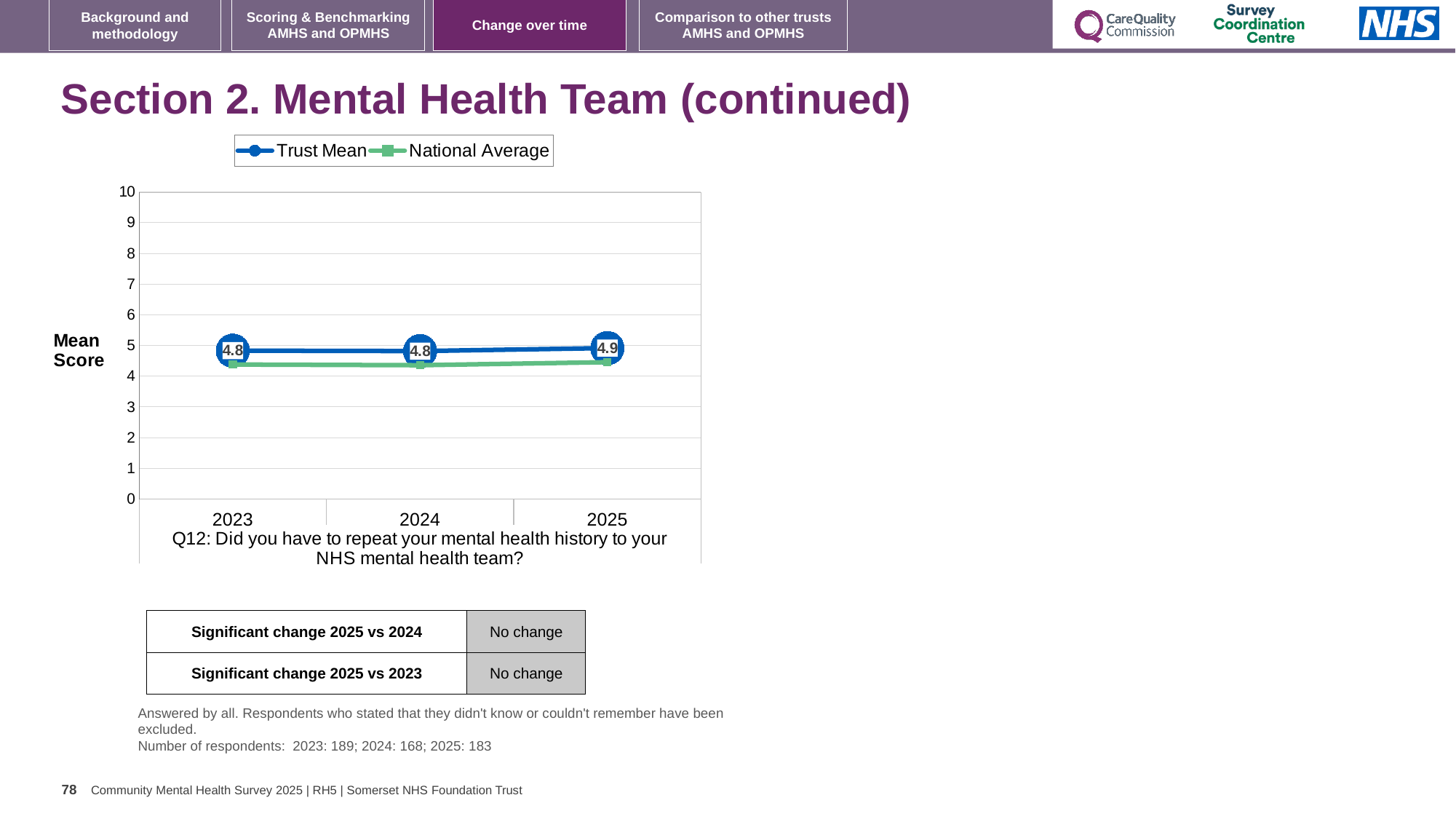
What is the label of the y axis? Mean Score How many series does the legend list? 2 What is the Trust Mean score for 2024? 4.8 In 2025, which is larger, the Trust Mean or the National Average? Trust Mean What is the Trust Mean score for 2025? 4.9 Is the National Average for 2023 greater or less than 5? less What kind of chart is shown? line chart In which year is the Trust Mean highest? 2025 What is the difference between the Trust Mean in 2025 and in 2023? 0.1 How many years are shown on the x axis? 3 Is the Trust Mean for 2025 greater or less than 4? greater What is the Trust Mean score for 2023? 4.8